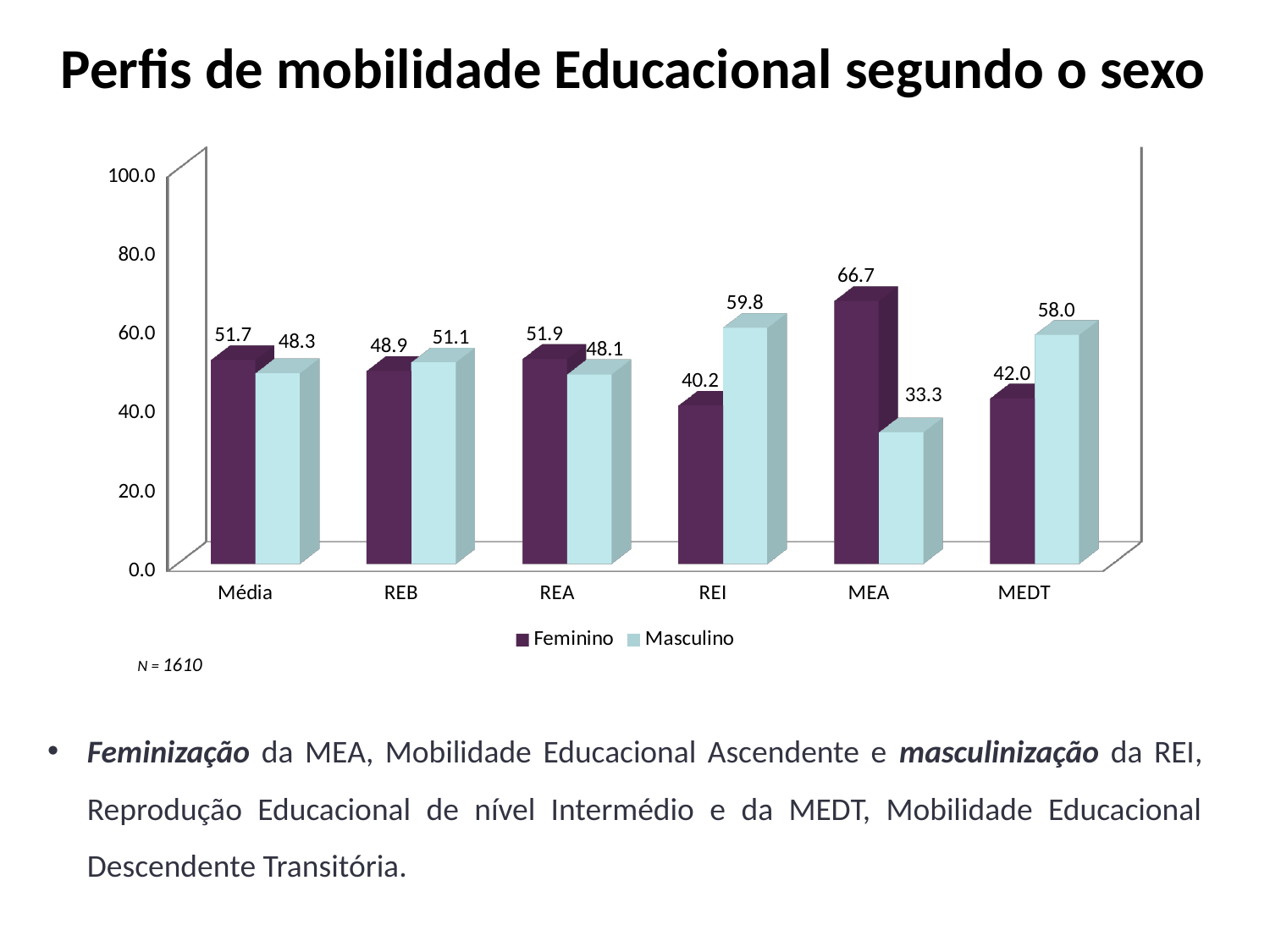
What is the Masculino value for MEDT? 58.0 What is the Feminino value for MEA? 66.7 How many categories are shown on the x axis? 6 What is the Feminino value for Média? 51.7 What is the Masculino value for REI? 59.8 How many series does the legend list? 2 Which category has the lowest Masculino value? MEA What sample size (N) is noted below the chart? N = 1610 What kind of chart is shown on the slide? Bar chart Which category has the highest Feminino value? MEA Which is larger for REI, the Feminino value or the Masculino value? Masculino What is the difference between the Feminino and Masculino values for MEA? 33.4